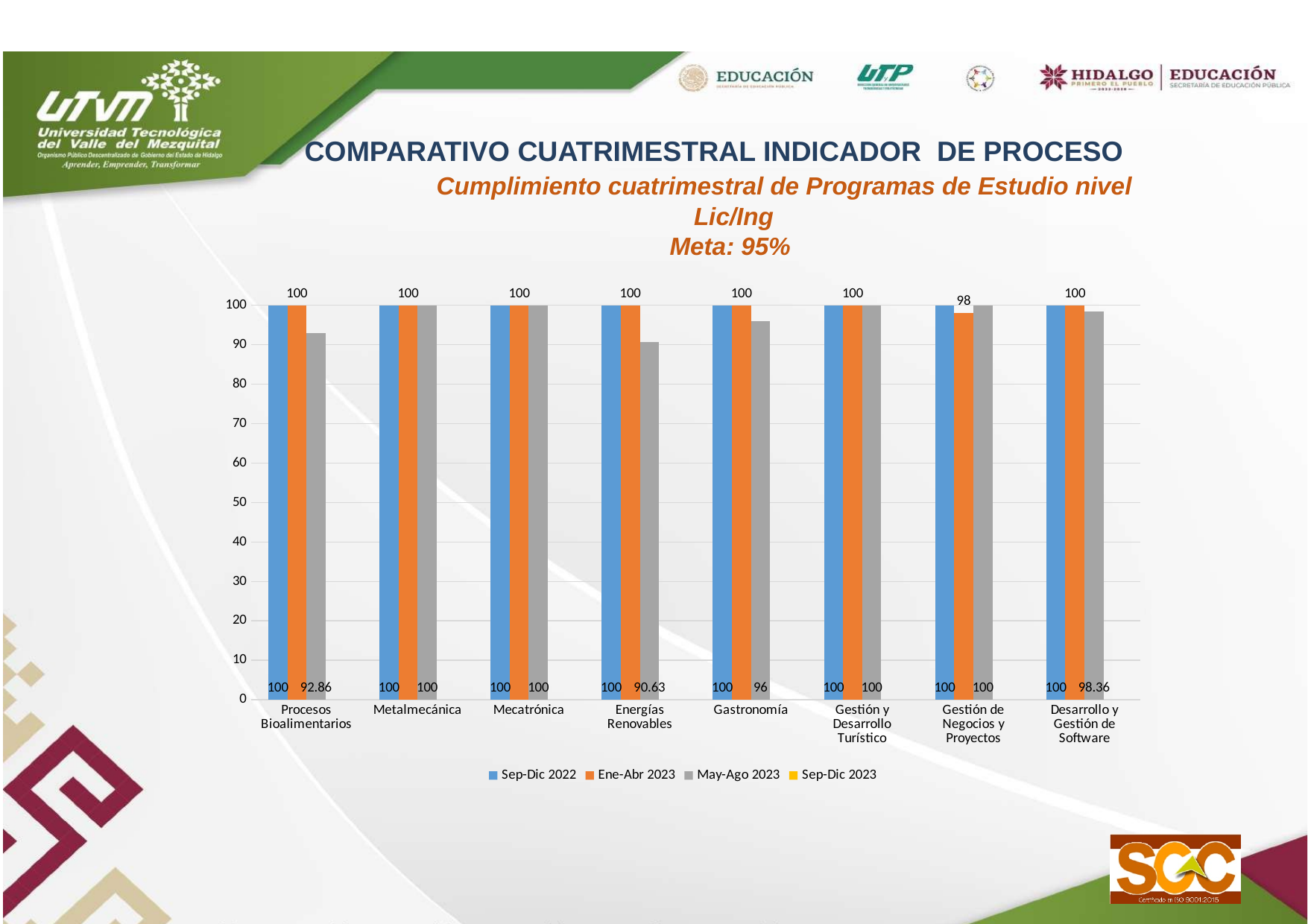
Which category has the lowest May-Ago 2023 value? Energías Renovables What kind of chart is shown on the slide? bar chart How many program categories are shown on the x axis? 8 What is the May-Ago 2023 value for Desarrollo y Gestión de Software? 98.36 What target (Meta) is stated in the chart title? 95% What is the difference between the Sep-Dic 2022 and May-Ago 2023 values for Gastronomía? 4 Which is larger, the May-Ago 2023 value for Procesos Bioalimentarios or for Gastronomía? Gastronomía What is the May-Ago 2023 value for Energías Renovables? 90.63 What is the Ene-Abr 2023 value for Gestión de Negocios y Proyectos? 98 What is the May-Ago 2023 value for Procesos Bioalimentarios? 92.86 How many series does the legend list? 4 What is the difference between the Sep-Dic 2022 and Ene-Abr 2023 values for Gestión de Negocios y Proyectos? 2